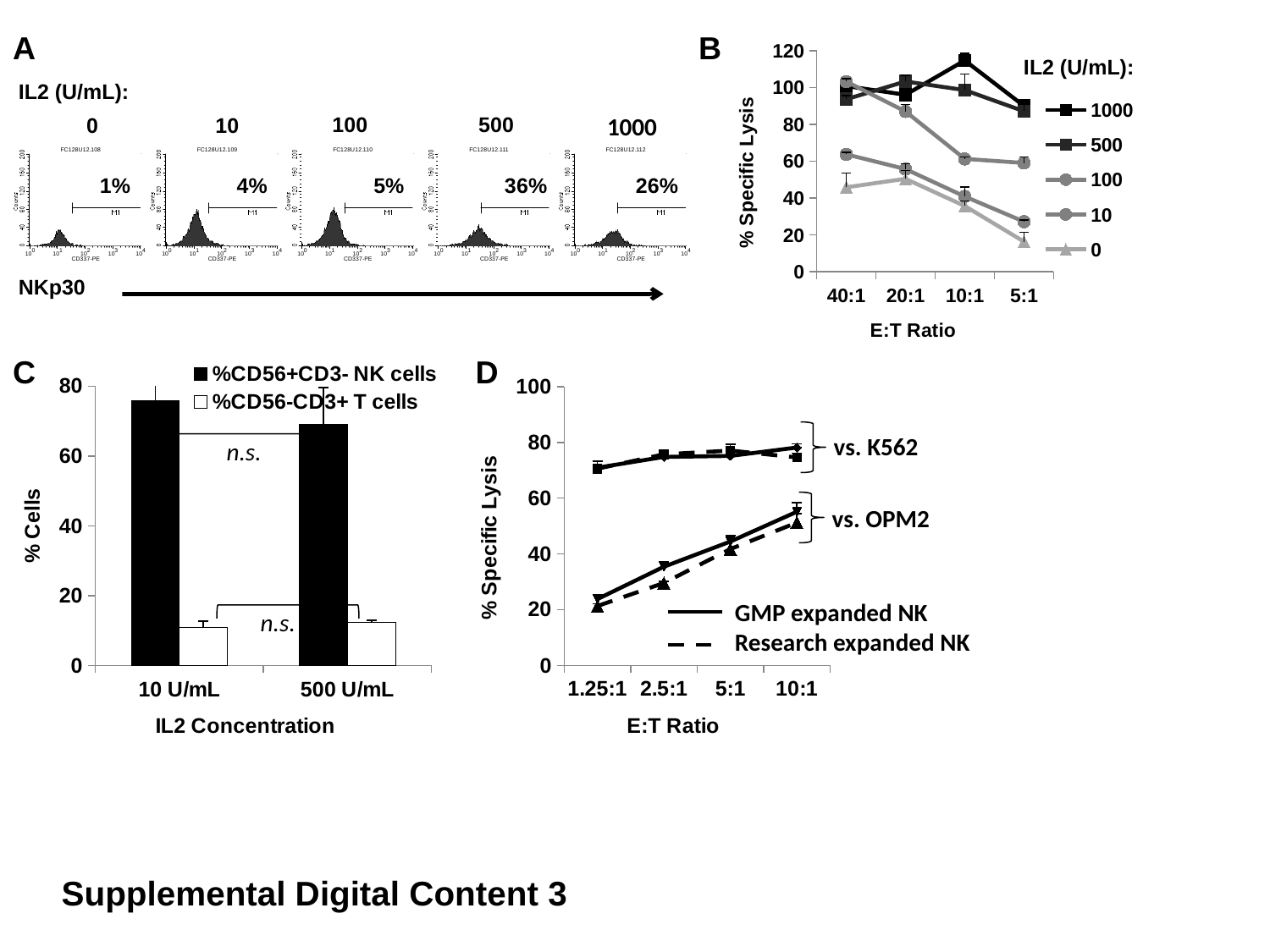
In panel B, does the % specific lysis for the 0 U/mL series rise or fall from 40:1 to 5:1? fall In panel A, which IL2 concentration has the highest percentage label? 500 In panel C, at 500 U/mL, which is larger: %CD56+CD3- NK cells or %CD56-CD3+ T cells? %CD56+CD3- NK cells In panel C, is the value for %CD56+CD3- NK cells at 10 U/mL greater or less than 60? greater In panel B, is the value for the 1000 U/mL series at 10:1 greater or less than 100? greater In panel B, how many IL2 concentrations does the legend list? 5 In panel B, how many E:T ratios are shown on the x axis? 4 In panel D, does the % specific lysis vs. OPM2 rise or fall as the E:T ratio increases from 1.25:1 to 10:1? rise In panel A, what percentage is shown for the IL2 concentration of 500 U/mL? 36% In panel D, how many series does the legend list? 2 What kind of chart is panel C? bar chart In panel A, what percentage is shown for the IL2 concentration of 0 U/mL? 1%